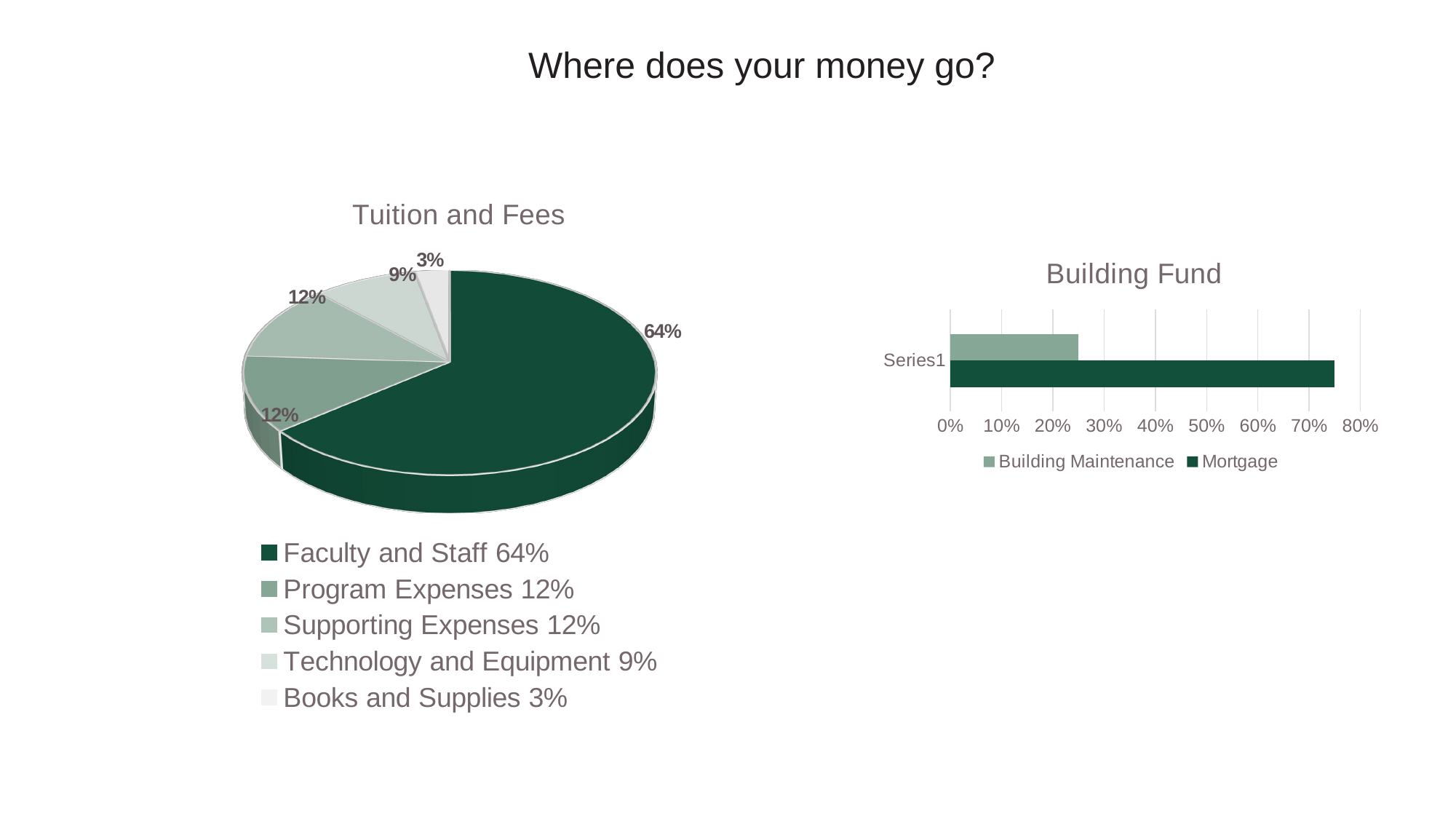
In the Tuition and Fees pie chart, how many categories are shown? 5 In the Tuition and Fees pie chart, which category has the largest slice? Faculty and Staff In the Building Fund chart, how many series does the legend list? 2 In the Tuition and Fees pie chart, what share goes to Faculty and Staff? 64% In the Building Fund chart, which series has the larger value: Building Maintenance or Mortgage? Mortgage In the Tuition and Fees pie chart, what is the difference between the Faculty and Staff share and the Program Expenses share? 52% What kind of chart is the Building Fund chart? Bar chart In the Tuition and Fees pie chart, what share goes to Technology and Equipment? 9% In the Tuition and Fees pie chart, which is larger: Technology and Equipment or Books and Supplies? Technology and Equipment In the Building Fund chart, is the value for Building Maintenance greater or less than 30%? less In the Building Fund chart, is the value for Mortgage greater or less than 70%? greater In the Tuition and Fees pie chart, which category has the smallest slice? Books and Supplies